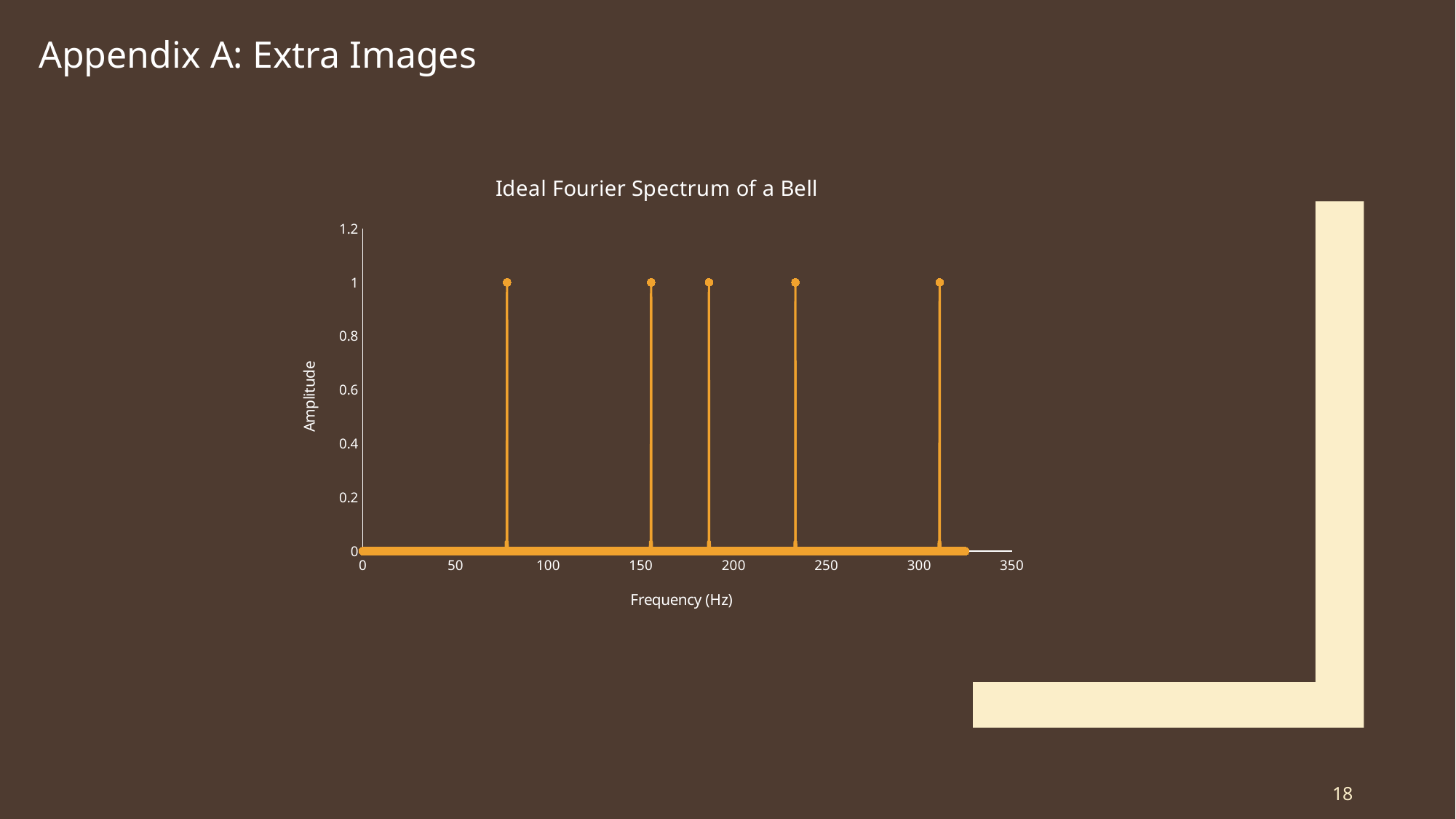
Is the frequency of the last (highest-frequency) spike greater or less than 300? greater How many spikes fall between 150 Hz and 200 Hz on the x axis? 2 How many spikes (peaks) are plotted in the spectrum? 5 What is the highest value shown on the y axis? 1.2 What is the title of the chart? Ideal Fourier Spectrum of a Bell How many spikes fall below 100 Hz on the x axis? 1 Is the frequency of the first (lowest-frequency) spike greater or less than 100? less What kind of chart is shown on the slide? line chart What is the label of the x axis? Frequency (Hz) Is the frequency of the first (lowest-frequency) spike greater or less than 50? greater What amplitude value do the spikes reach? 1